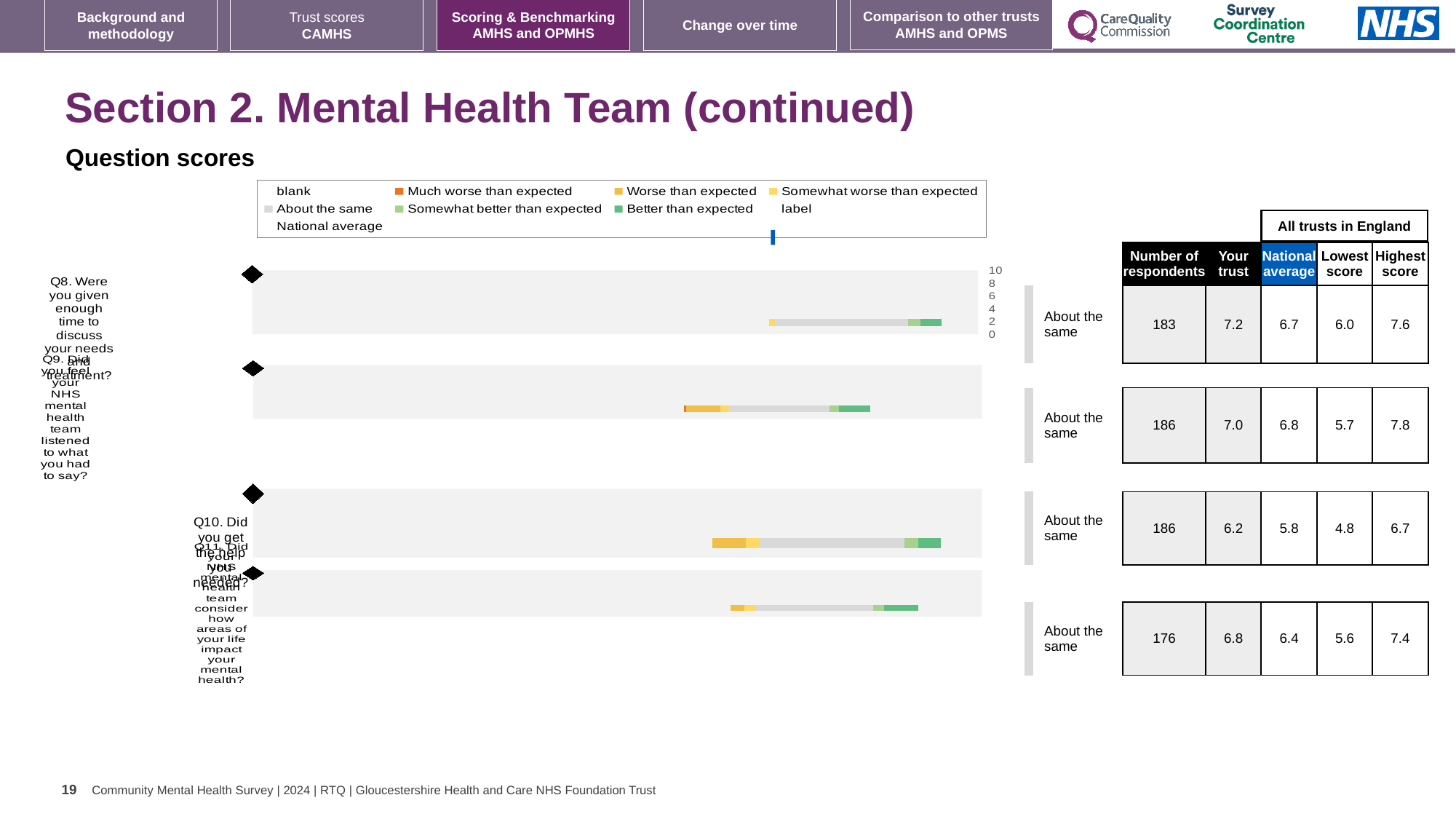
In the table beside the chart, what is the national average for Q10? 5.8 In the table beside the chart, which question has the highest 'Highest score' across all trusts in England? Q9 In the table beside the chart, what is the difference between the 'Your trust' score and the national average for Q8? 0.5 What is the highest value shown on the chart's numeric axis? 10 In the table beside the chart, which question has the lowest 'Your trust' score? Q10 In the table beside the chart, what is the 'Your trust' score for Q8? 7.2 How many questions (categories) are plotted in the chart? 4 In the table beside the chart, what is the lowest score across all trusts in England for Q10? 4.8 What colour does the legend use for 'Much worse than expected'? orange In the table beside the chart, is the 'Your trust' score for Q9 larger or smaller than the national average for Q9? larger In the table beside the chart, how many respondents answered Q11? 176 What kind of chart is shown under 'Question scores'? bar chart